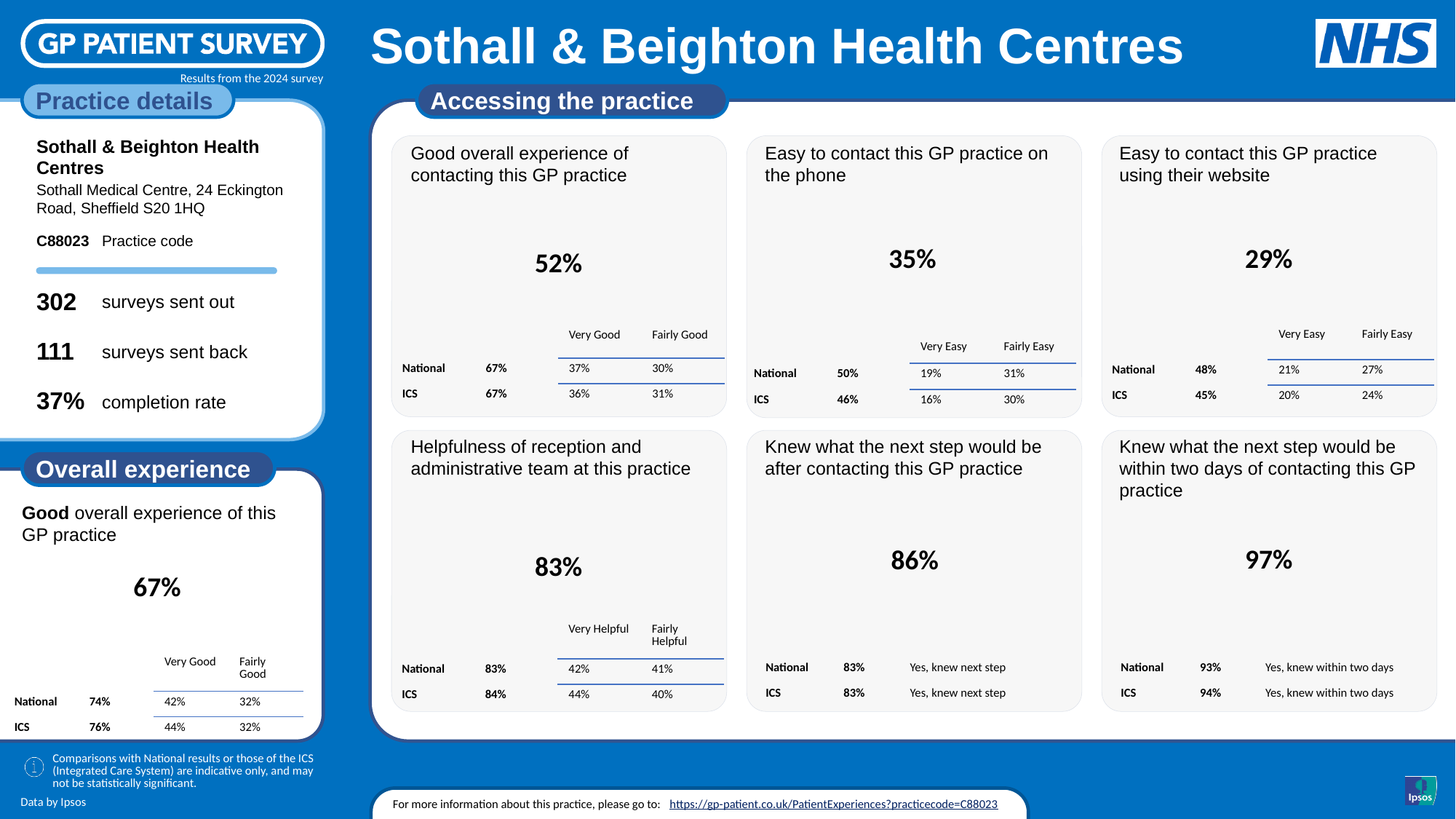
On the 'Good overall experience of contacting this GP practice' panel, what is the practice's headline value? 52% On the 'Easy to contact this GP practice on the phone' panel, which is larger: the National value or the ICS value? National On the 'Good overall experience of contacting this GP practice' panel, what is the difference between the National value and the practice's headline value? 15% Across the six 'Accessing the practice' panels, which measure has the lowest headline value? Easy to contact this GP practice using their website How many panels are shown in the 'Accessing the practice' section? 6 On the 'Good overall experience of this GP practice' panel, what is the difference between the ICS value and the National value? 2% Across the six 'Accessing the practice' panels, which measure has the highest headline value? Knew what the next step would be within two days of contacting this GP practice On the 'Knew what the next step would be after contacting this GP practice' panel, what is the ICS value? 83% On the 'Helpfulness of reception and administrative team at this practice' panel, what is the ICS value for Very Helpful? 44% On the 'Knew what the next step would be within two days of contacting this GP practice' panel, what is the practice's headline value? 97% On the 'Easy to contact this GP practice on the phone' panel, what is the practice's headline value? 35% On the 'Easy to contact this GP practice using their website' panel, what is the National value? 48%